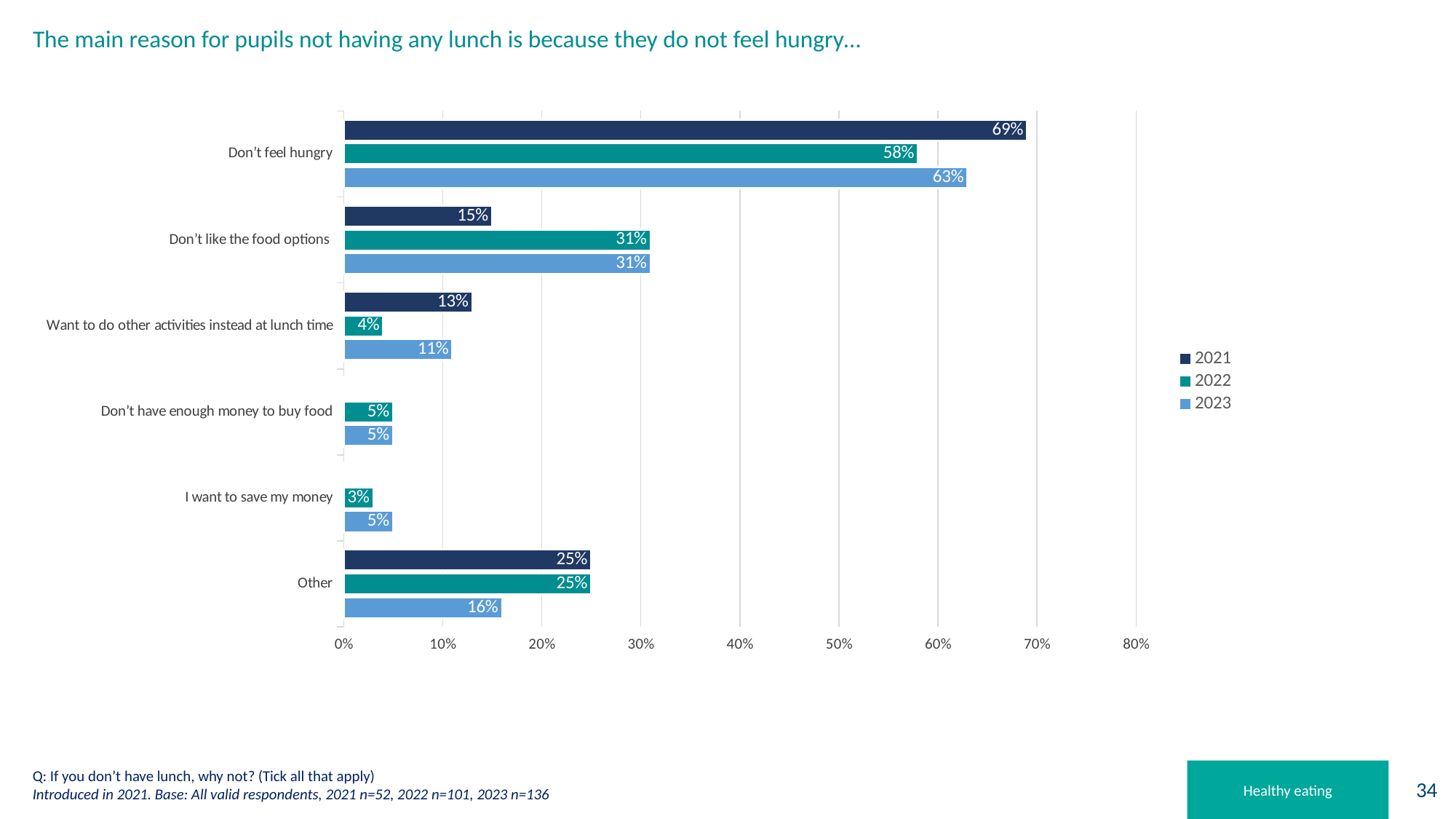
What is the 2023 value for 'Don't like the food options'? 31% What kind of chart is shown on the slide? Bar chart What percentage of pupils said they don't feel hungry in 2021? 69% Which reason has the lowest value in 2022? I want to save my money Which reason has the highest value in 2023? Don't feel hungry Which year is represented by the light blue bars in the legend? 2023 What is the 2023 value for 'Other'? 16% How many series does the legend list? 3 How many reason categories are shown on the chart? 6 What is the difference between the 2021 and 2022 values for 'Don't feel hungry'? 11 percentage points Which is larger for 'Want to do other activities instead at lunch time': the 2021 value or the 2023 value? 2021 What is the 2022 value for 'Want to do other activities instead at lunch time'? 4%